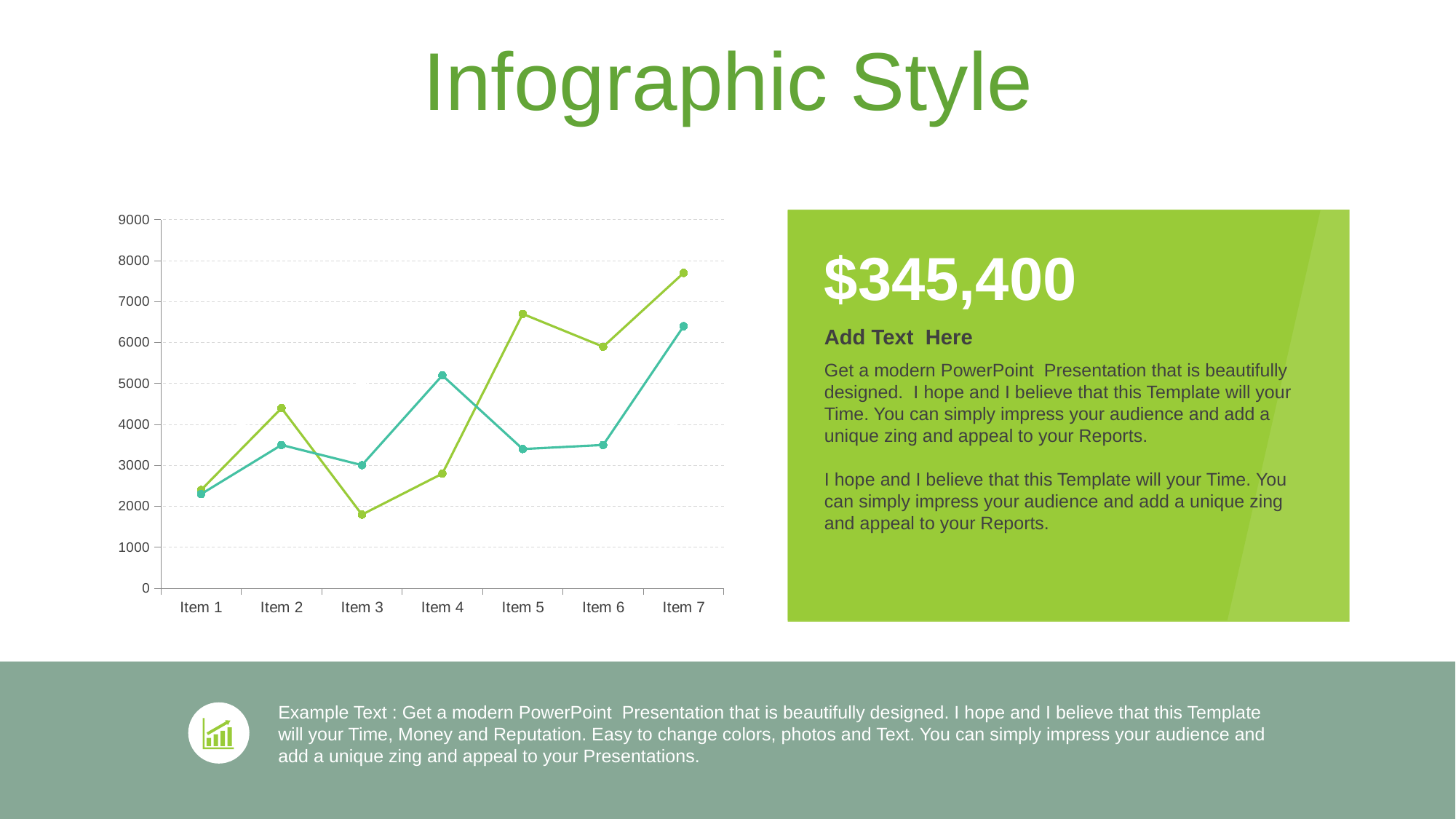
Is the value of the teal line at Item 7 greater or less than 6000? greater Is the value of the light green line at Item 7 greater or less than 7000? greater At Item 5, which line has the higher value, the light green line or the teal line? the light green line Does the light green line rise or fall from Item 5 to Item 6? fall Is the value of the teal line at Item 4 greater or less than 4000? greater How many items are shown along the x axis of the chart? 7 What kind of chart is shown on the slide? line chart At which item does the light green line reach its lowest value? Item 3 At which item does the light green line reach its highest value? Item 7 At which item does the teal line reach its lowest value? Item 1 How many lines are plotted on the chart? 2